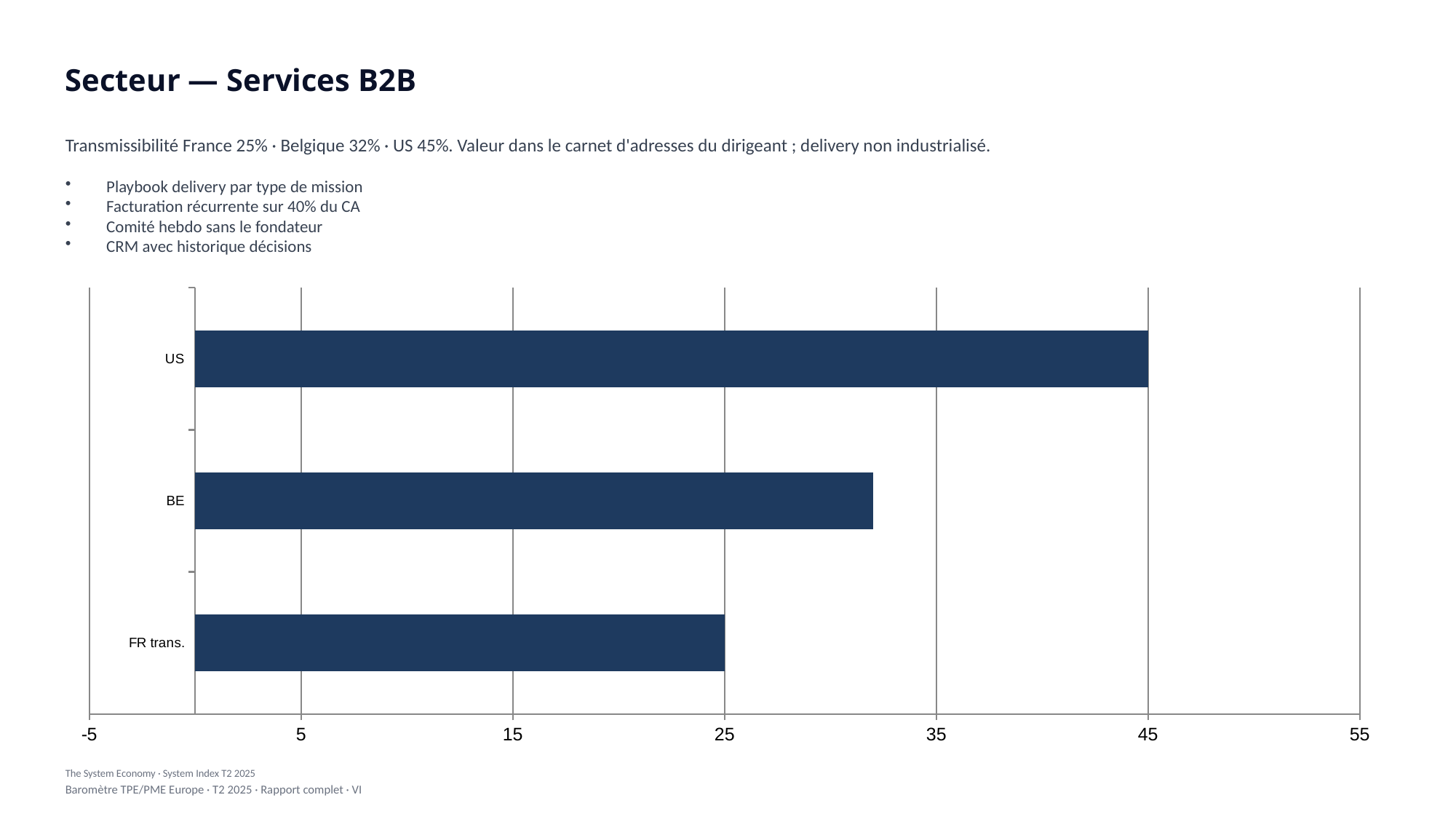
Which is larger, the value for BE or the value for FR trans.? BE Which category has the lowest value in the bar chart? FR trans. What is the value for FR trans. in the bar chart? 25 Is the value for US greater or less than 35? greater Is the value for BE greater or less than 35? less How many categories are shown in the bar chart? 3 What is the value for US in the bar chart? 45 What kind of chart is shown on the slide? bar chart What is the difference between the values for US and FR trans.? 20 What colour are the bars in the chart? dark navy blue Which category has the highest value in the bar chart? US Is the value for BE greater or less than 25? greater